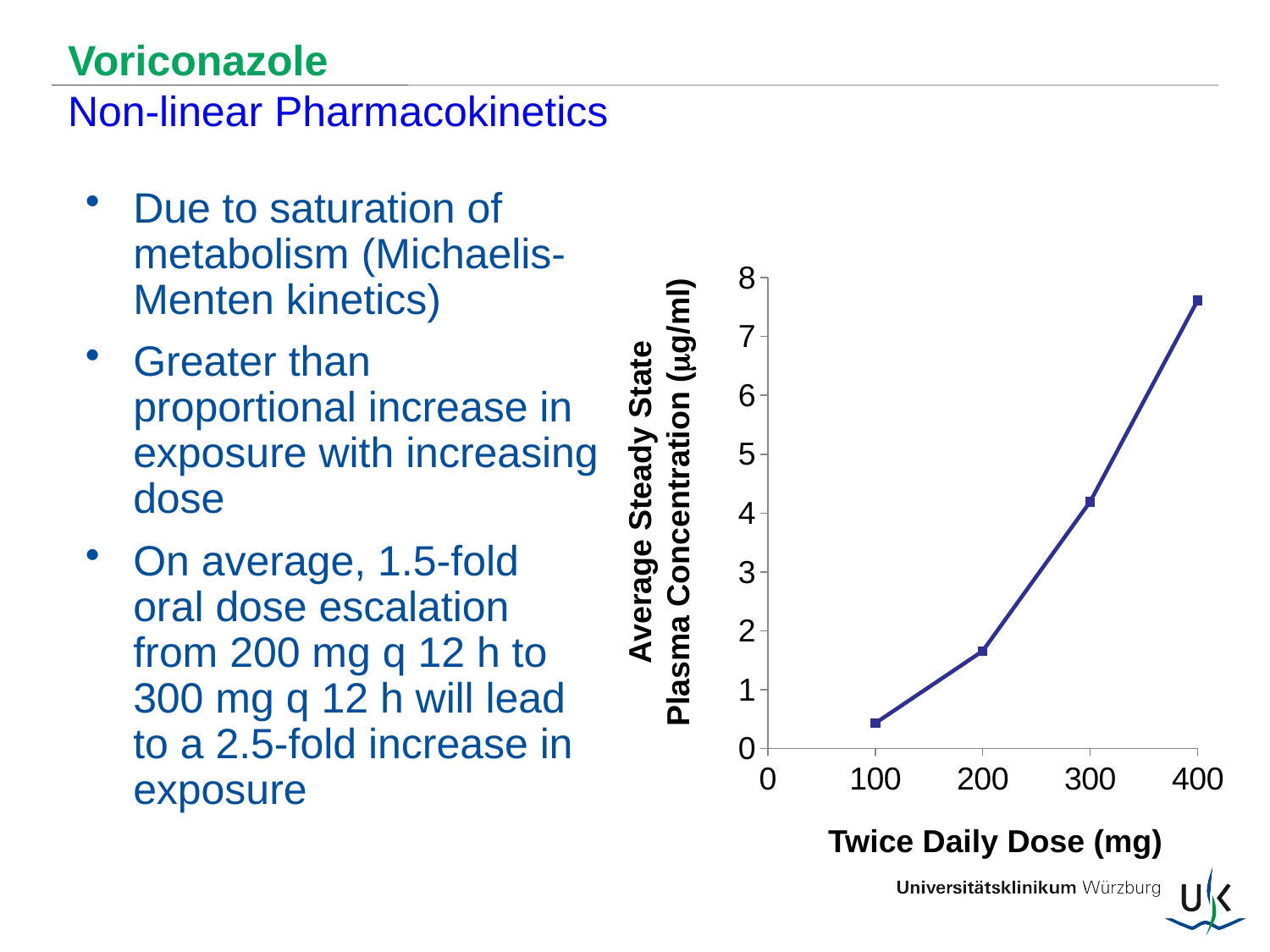
Is the plasma concentration at a twice daily dose of 400 mg greater or less than 7? greater Which twice daily dose has the lowest average steady state plasma concentration? 100 mg Is the plasma concentration at a twice daily dose of 300 mg greater or less than 4? greater What is the label of the y axis of the chart? Average Steady State Plasma Concentration (µg/ml) Which has the larger plasma concentration: a twice daily dose of 200 mg or 300 mg? 300 mg Which twice daily dose has the highest average steady state plasma concentration? 400 mg Is the plasma concentration at a twice daily dose of 200 mg greater or less than 2? less What kind of chart is shown on the slide? line chart What is the label of the x axis of the chart? Twice Daily Dose (mg) Do the plasma concentration values rise or fall as the twice daily dose increases along the x axis? rise How many data points are plotted on the line? 4